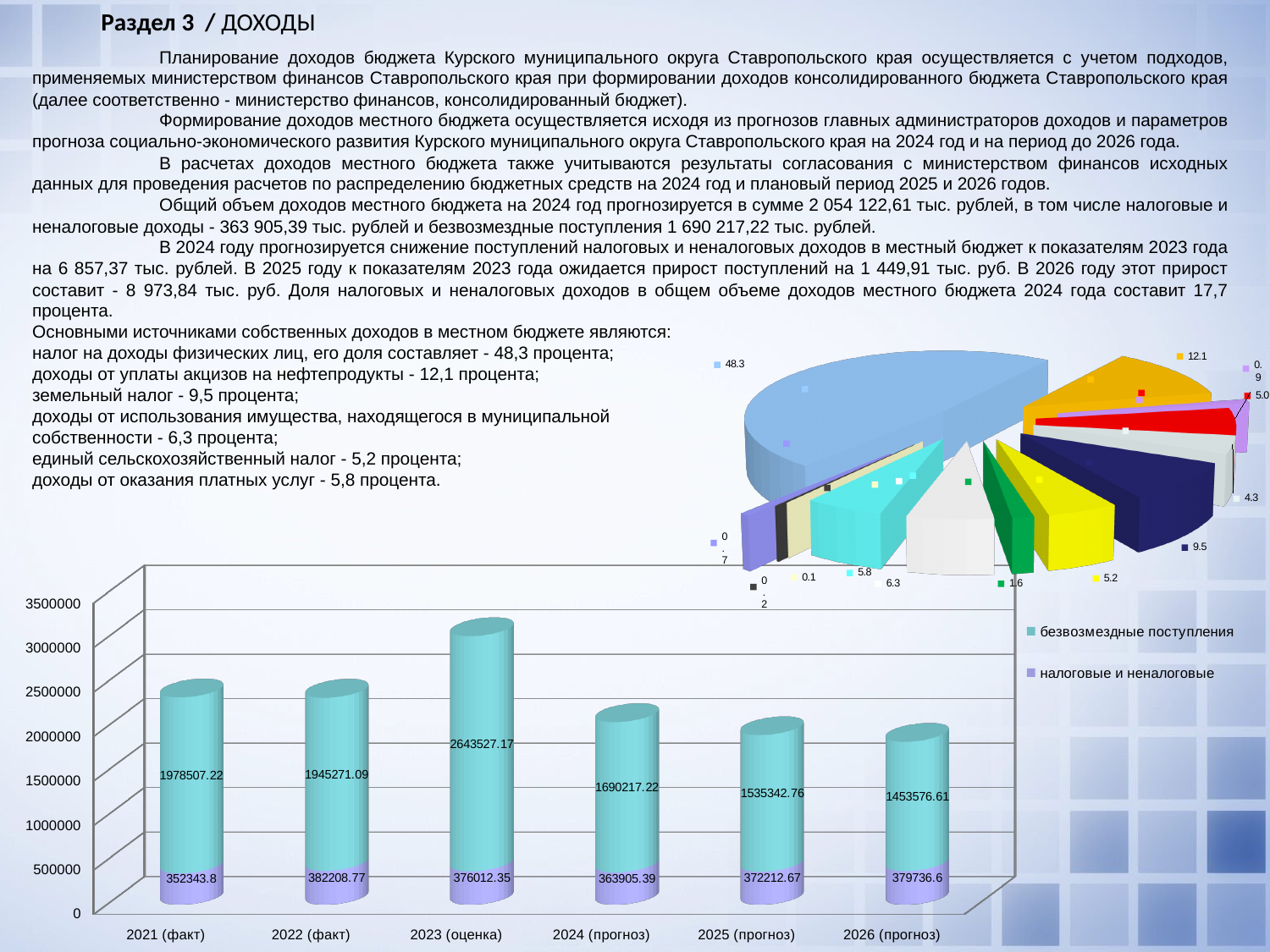
On the bar chart at the bottom of the slide, how many categories are shown on the x axis? 6 On the bar chart at the bottom of the slide, which category has the highest value of безвозмездные поступления? 2023 (оценка) On the bar chart at the bottom of the slide, what is the value of безвозмездные поступления for 2026 (прогноз)? 1453576.61 On the bar chart at the bottom of the slide, what is the value of безвозмездные поступления for 2024 (прогноз)? 1690217.22 On the bar chart at the bottom of the slide, which is larger: налоговые и неналоговые in 2022 (факт) or in 2021 (факт)? 2022 (факт) On the bar chart at the bottom of the slide, how many series does the legend list? 2 On the bar chart at the bottom of the slide, what is the total of the stacked bar for 2024 (прогноз)? 2054122.61 On the bar chart at the bottom of the slide, what is the value of налоговые и неналоговые for 2021 (факт)? 352343.8 What kind of chart is shown at the bottom of the slide? Stacked bar chart On the bar chart at the bottom of the slide, which category has the lowest value of безвозмездные поступления? 2026 (прогноз) On the pie chart at the top right of the slide, what is the value of the largest slice? 48.3 On the bar chart at the bottom of the slide, what is the difference between безвозмездные поступления in 2023 (оценка) and 2024 (прогноз)? 953309.95